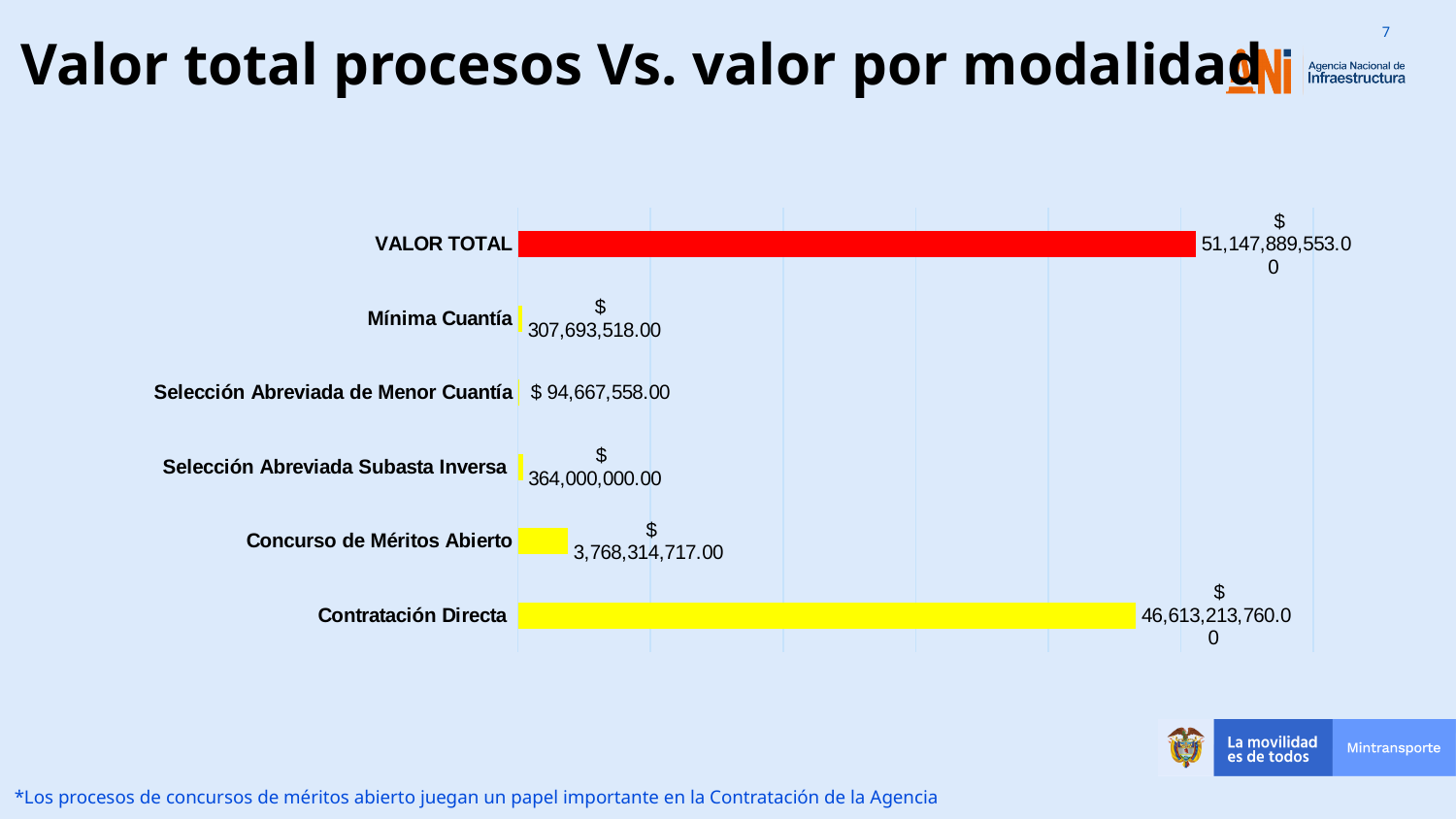
What kind of chart is shown on the slide? Bar chart What is the value shown for Concurso de Méritos Abierto? $ 3,768,314,717.00 What is the difference between the values for Selección Abreviada Subasta Inversa and Mínima Cuantía? $ 56,306,482.00 What is the value shown for Selección Abreviada Subasta Inversa? $ 364,000,000.00 Which is larger, the value for Mínima Cuantía or the value for Selección Abreviada de Menor Cuantía? Mínima Cuantía What is the value shown for Contratación Directa? $ 46,613,213,760.00 What is the difference between the values for Contratación Directa and Concurso de Méritos Abierto? $ 42,844,899,043.00 What is the value shown for Mínima Cuantía? $ 307,693,518.00 Excluding VALOR TOTAL, which modality has the highest value? Contratación Directa Which category has the lowest value? Selección Abreviada de Menor Cuantía What is the value shown for VALOR TOTAL? $ 51,147,889,553.00 How many bars are shown in the chart? 6